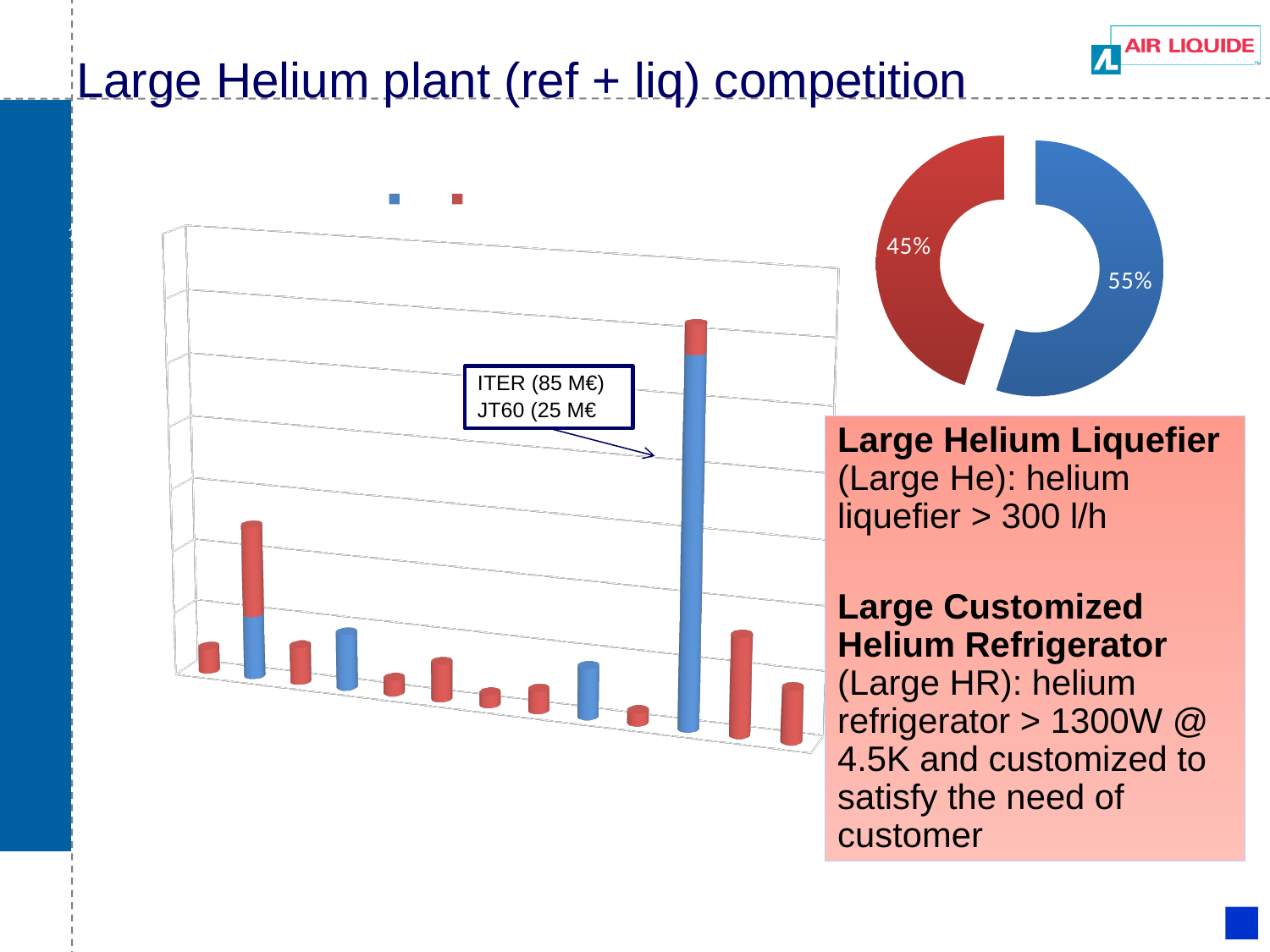
How many series does the legend of the bar chart on the left show? 2 In the bar chart on the left, what does the annotation box pointing to the tallest bar say? ITER (85 M€) JT60 (25 M€ What kind of chart is shown on the right side of the slide? doughnut (pie) chart In the bar chart on the left, what colour is the tallest bar mostly? blue What kind of chart is shown on the left side of the slide? bar chart In the doughnut chart on the right, what is the difference in percentage points between the blue slice and the red slice? 10 percentage points How many slices does the doughnut chart on the right have? 2 In the doughnut chart on the right, what percentage is shown for the blue slice? 55% In the doughnut chart on the right, what percentage is shown for the red slice? 45% In the doughnut chart on the right, which slice is larger, the red one or the blue one? the blue one